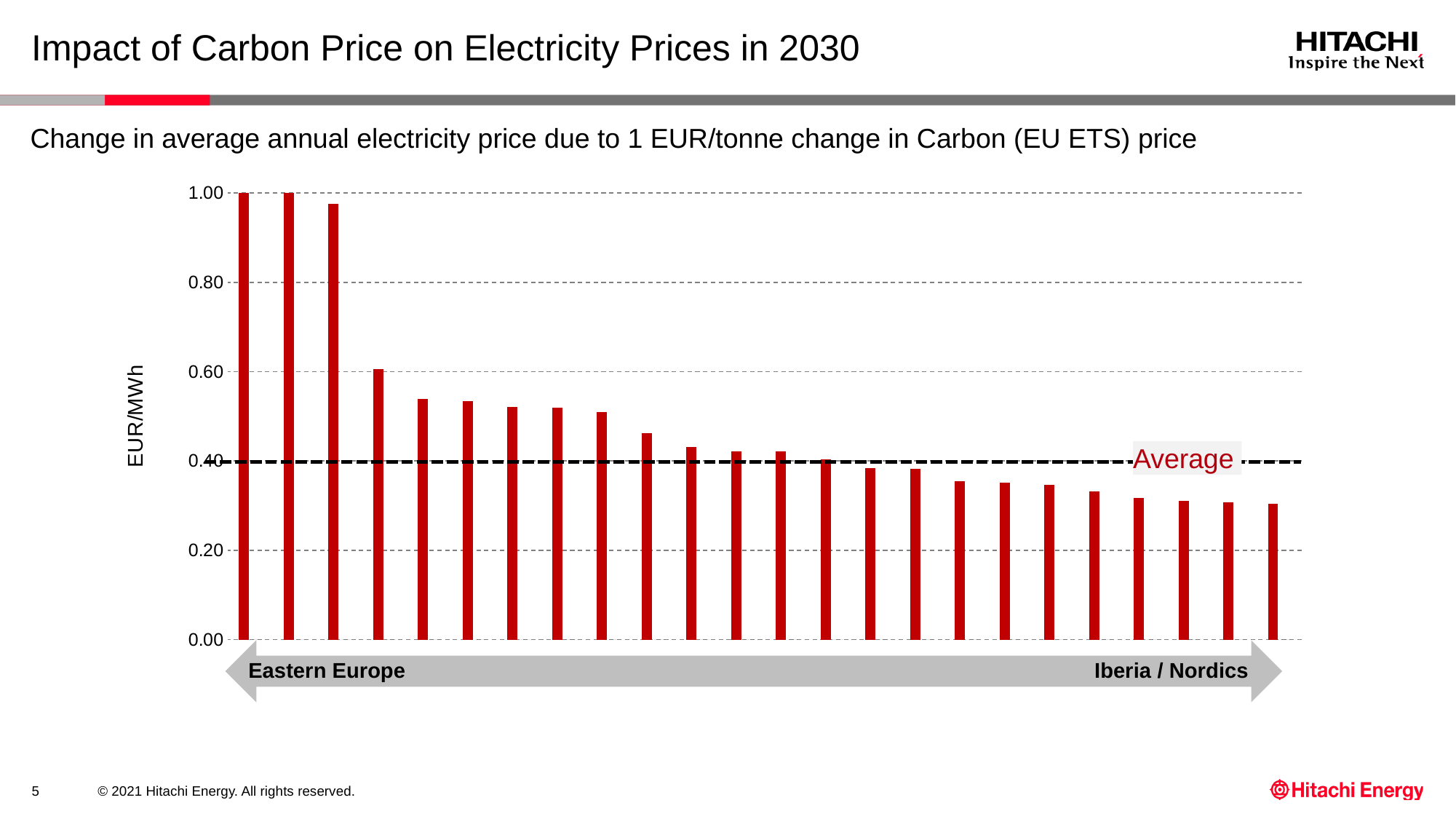
Is the value of the rightmost bar greater or less than 0.40? less How many bars have values above 0.80? 3 Is the value of the fourth bar from the left greater or less than 0.40? greater Do the bar values rise or fall moving from left to right along the x axis? Fall What is the label on the y axis of the chart? EUR/MWh What kind of chart is shown on the slide? Bar chart What do the two labels at the ends of the arrow below the chart say? Eastern Europe and Iberia / Nordics Is the value of the leftmost bar greater or less than 0.80? greater Which is larger, the leftmost bar or the rightmost bar? The leftmost bar How many bars are plotted in the chart? 24